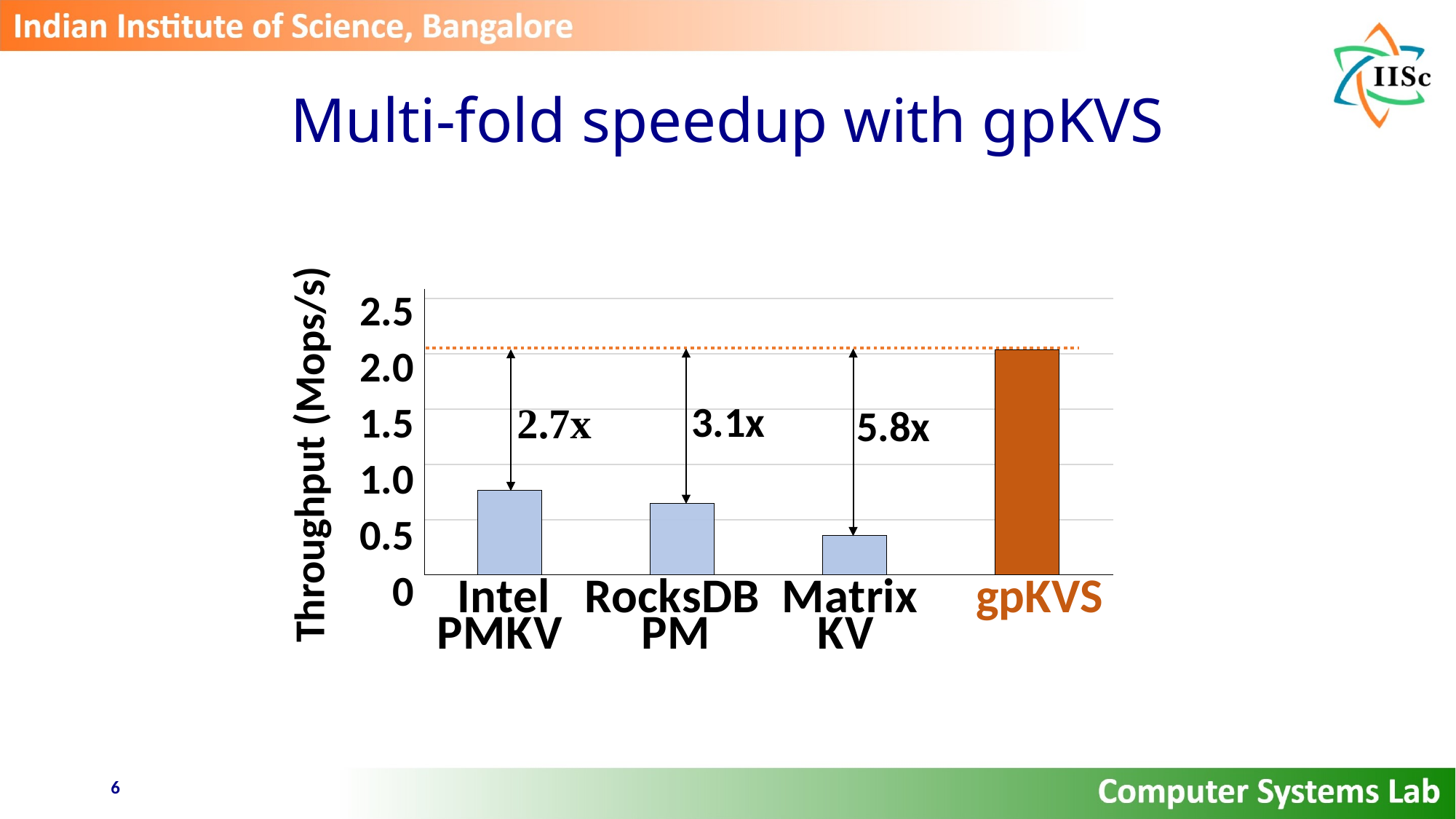
Is the throughput for gpKVS greater or less than 1.5 Mops/s? greater Is the throughput for Intel PMKV greater or less than 1.0 Mops/s? less How many systems (categories) are plotted on the x axis of the chart? 4 What kind of chart is shown on the slide? bar chart What speedup factor is annotated for gpKVS over Intel PMKV? 2.7x Which system has the lowest throughput in the chart? Matrix KV Is the throughput for Matrix KV greater or less than 0.5 Mops/s? less What speedup factor is annotated for gpKVS over Matrix KV? 5.8x What is the label of the y axis of the chart? Throughput (Mops/s) What speedup factor is annotated for gpKVS over RocksDB PM? 3.1x Which has higher throughput, Intel PMKV or Matrix KV? Intel PMKV Which system has the highest throughput in the chart? gpKVS